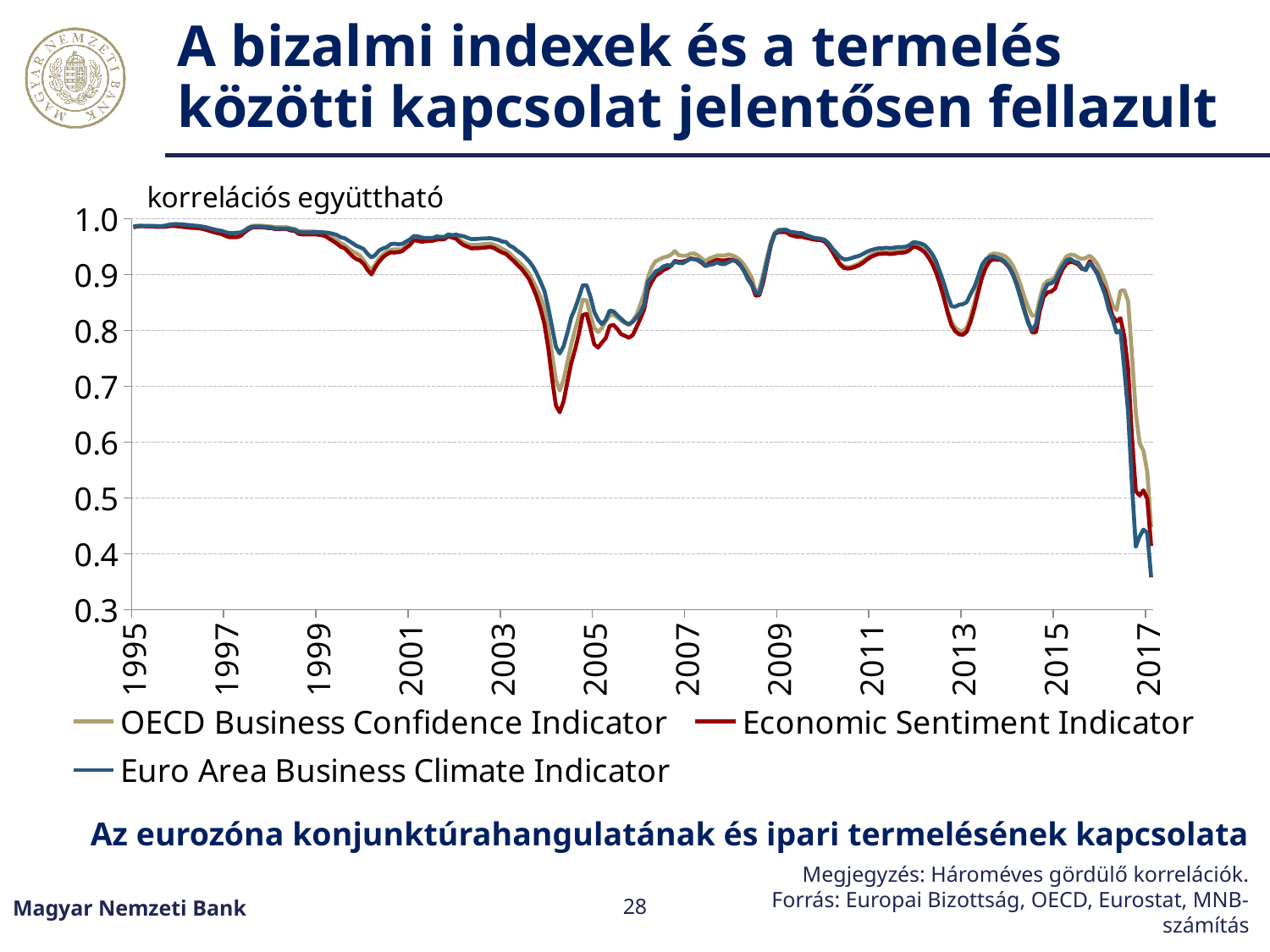
Do the plotted correlation coefficients rise or fall overall between 1995 and 2017? fall Which series reaches the lowest value in the dip around 2004? Economic Sentiment Indicator Which series ends at the lowest value in 2017? Euro Area Business Climate Indicator Which series is plotted in red? Economic Sentiment Indicator What label is written above the vertical axis? korrelációs együttható How many series does the legend list? 3 What kind of chart is shown on the slide? line chart Is the value of the Euro Area Business Climate Indicator at its dip around 2004 greater or less than 0.7? greater Is the value of the Euro Area Business Climate Indicator at the end of the series in 2017 greater or less than 0.4? less Is the value of the OECD Business Confidence Indicator in 1995 greater or less than 0.9? greater Around 2004, which is larger: the Euro Area Business Climate Indicator or the Economic Sentiment Indicator? Euro Area Business Climate Indicator